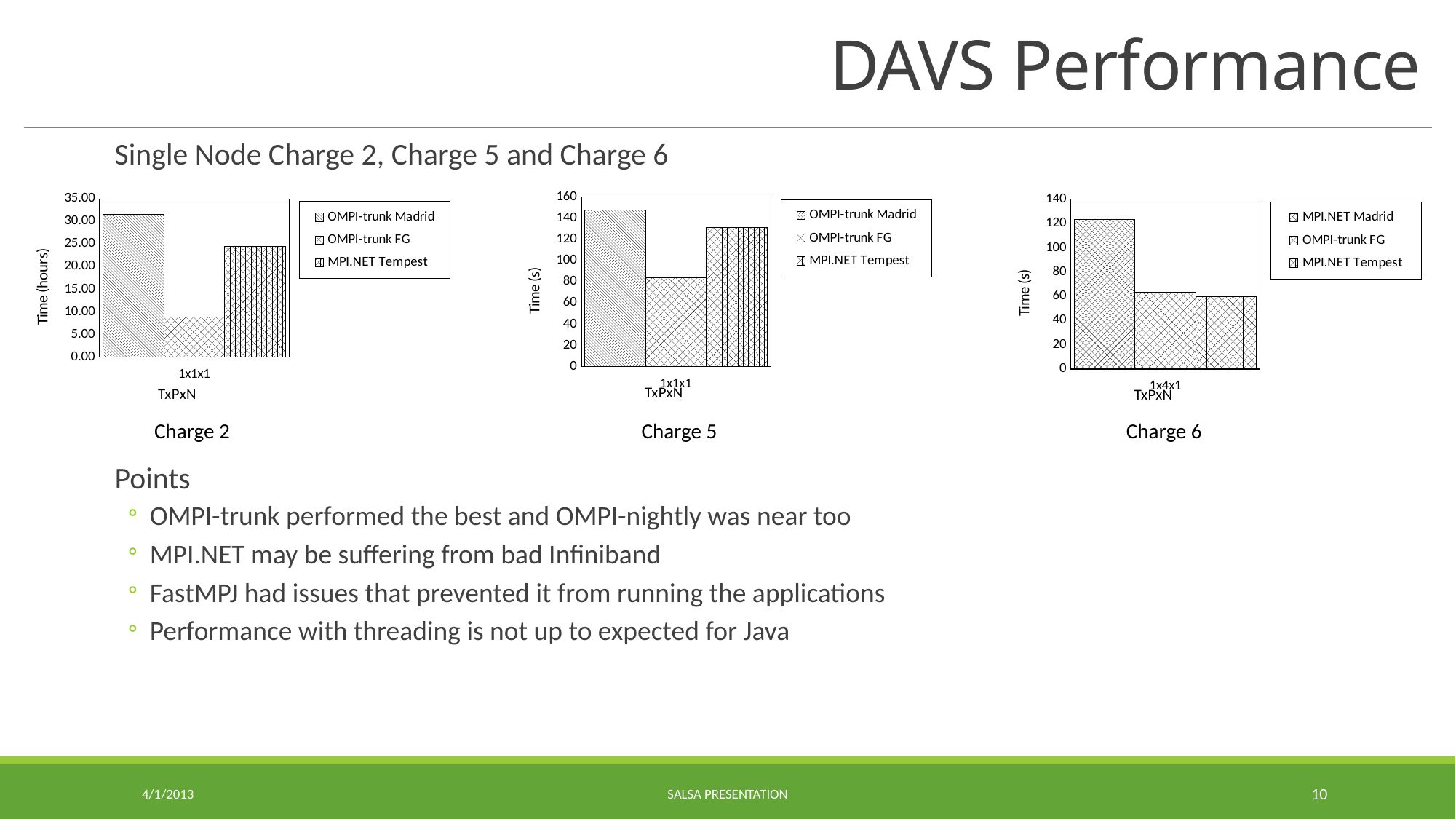
What is the y-axis label of the Charge 2 chart? Time (hours) What kind of chart is the Charge 2 chart? bar chart In the Charge 5 chart, is the value for OMPI-trunk Madrid greater or less than 140? greater In the Charge 5 chart, which series has the lowest value? OMPI-trunk FG What is the x-axis category label shown in the Charge 6 chart? 1x4x1 In the Charge 5 chart, which is larger, OMPI-trunk Madrid or MPI.NET Tempest? OMPI-trunk Madrid In the Charge 2 chart, which series has the highest value? OMPI-trunk Madrid In the Charge 6 chart, is the value for MPI.NET Madrid greater or less than 120? greater How many series does the legend of the Charge 5 chart list? 3 In the Charge 6 chart, which series has the highest value? MPI.NET Madrid In the Charge 2 chart, is the value for OMPI-trunk Madrid greater or less than 30.00? greater In the Charge 2 chart, which series has the lowest value? OMPI-trunk FG